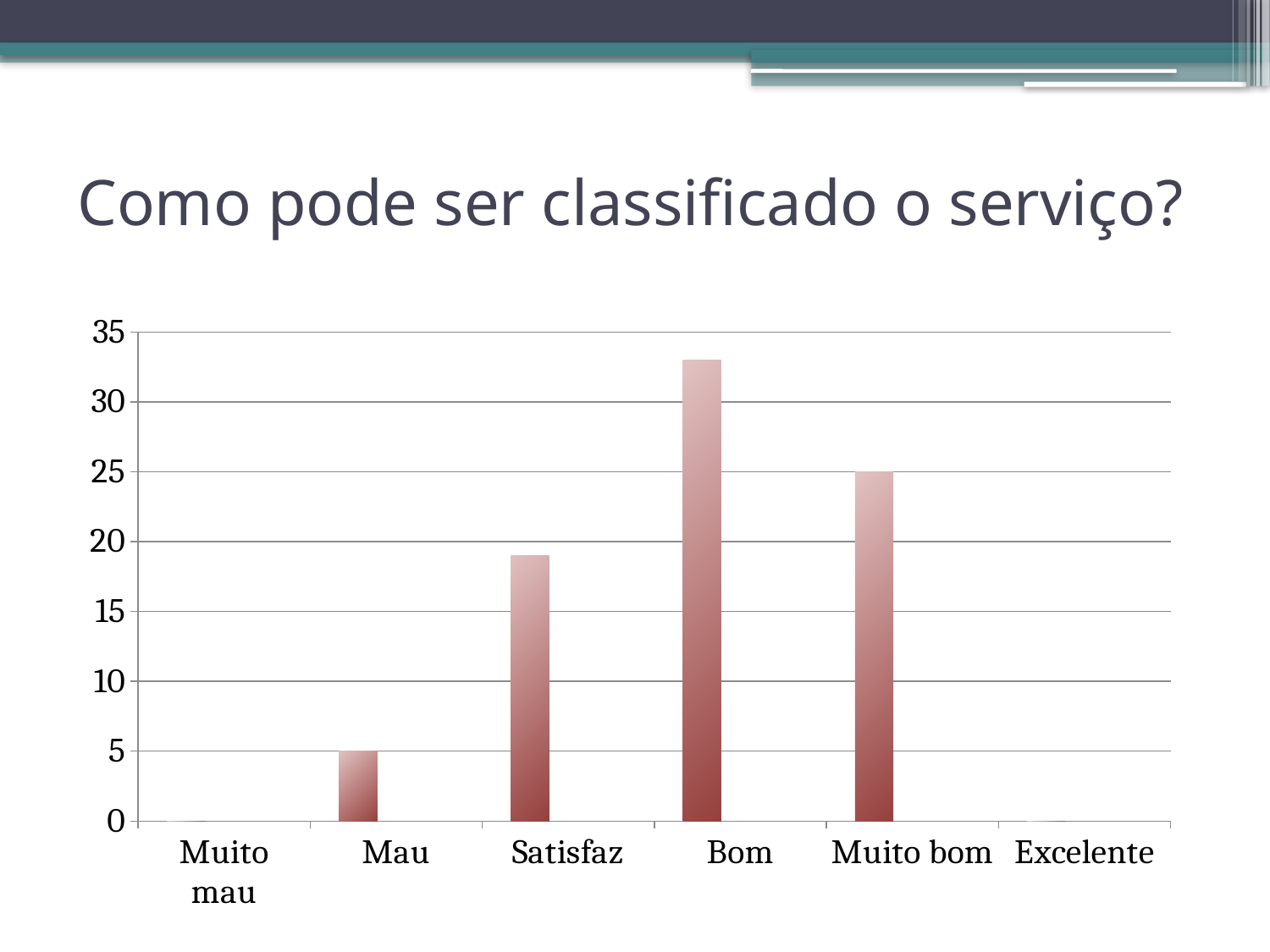
Which is larger, the value for Bom or the value for Muito bom? Bom What is the title of the chart on the slide? Como pode ser classificado o serviço? What is the value for Muito bom? 25 Is the value for Satisfaz greater or less than 20? less What is the difference between the value for Muito bom and the value for Mau? 20 What is the value for Muito mau? 0 Which category has the highest bar in the chart? Bom How many categories are shown on the x axis of the chart? 6 What is the value for Mau? 5 What is the value for Excelente? 0 What kind of chart is shown on the slide? bar chart Is the value for Bom greater or less than 30? greater